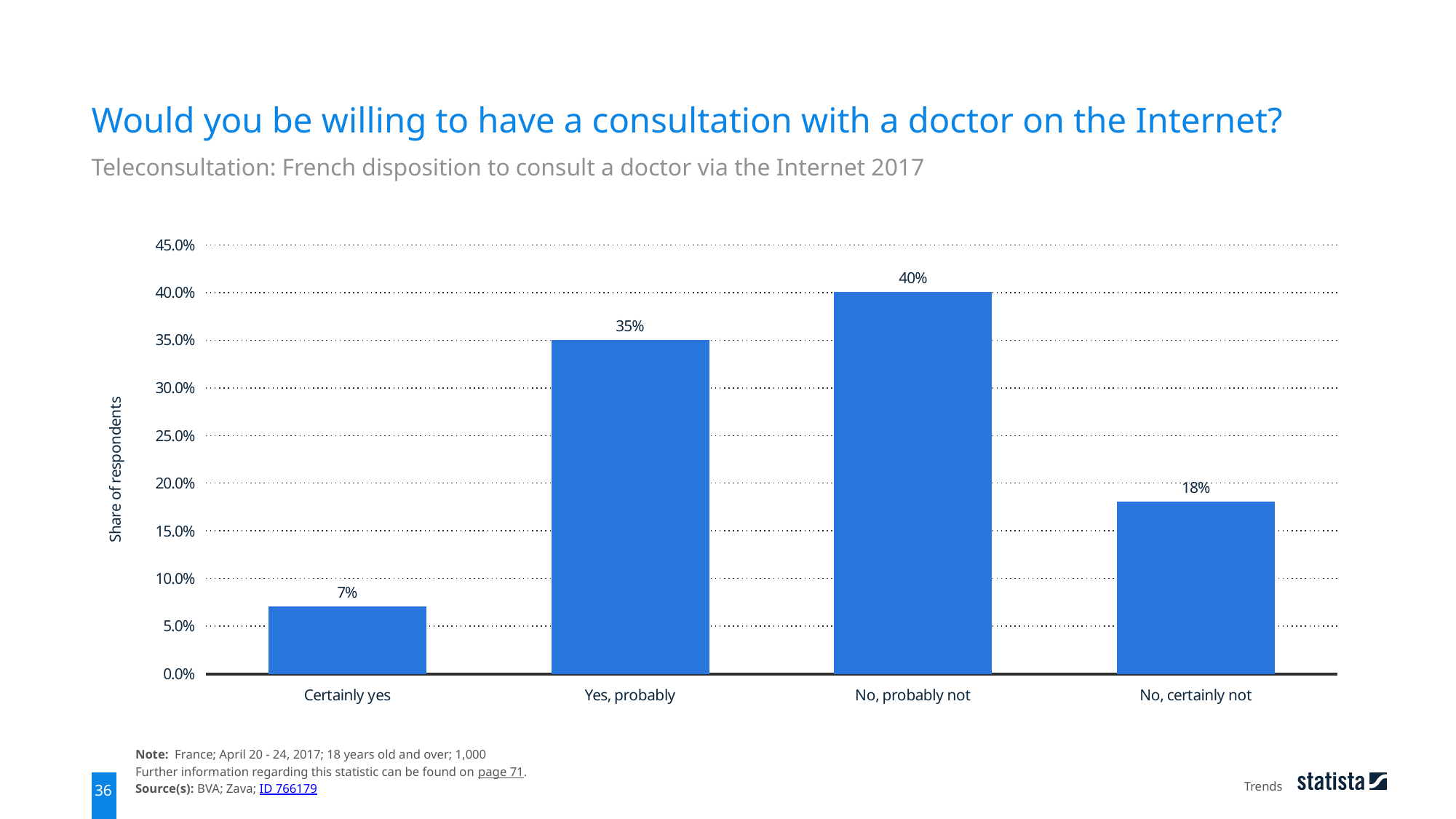
What share of respondents answered "Yes, probably"? 35% Which is larger, the share for "Yes, probably" or the share for "No, certainly not"? Yes, probably What is the difference between the shares for "No, probably not" and "Yes, probably"? 5% What is the difference between the shares for "No, certainly not" and "Certainly yes"? 11% What kind of chart is shown on the slide? Bar chart What share of respondents answered "No, certainly not"? 18% How many response categories are shown on the chart? 4 Which response category has the lowest share of respondents? Certainly yes Which response category has the highest share of respondents? No, probably not What share of respondents answered "No, probably not"? 40% What is the label of the vertical axis? Share of respondents What share of respondents answered "Certainly yes"? 7%